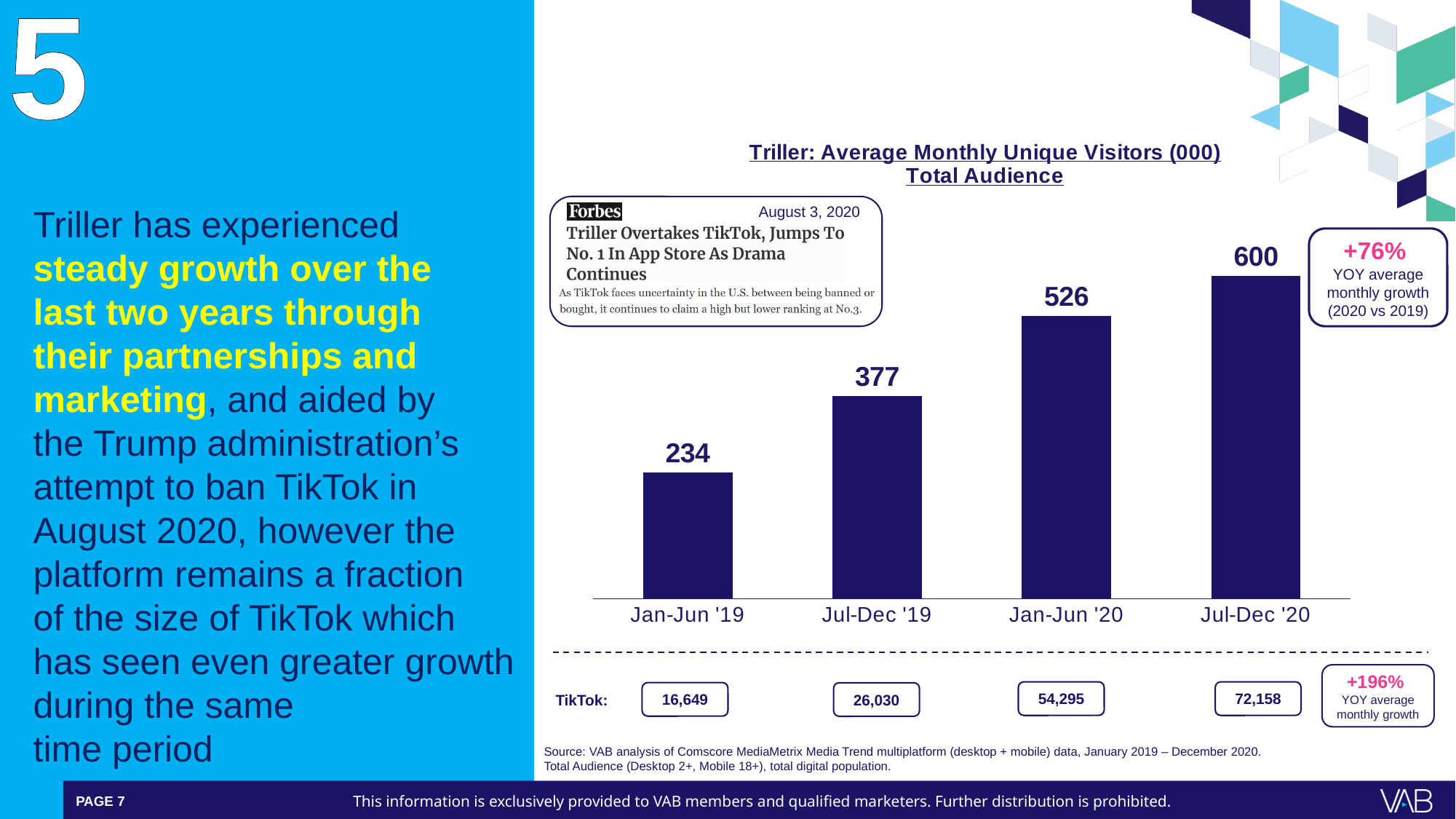
What YOY average monthly growth (2020 vs 2019) is shown in the callout next to the Triller chart? +76% In the Triller: Average Monthly Unique Visitors chart, which is larger: Jul-Dec '19 or Jan-Jun '20? Jan-Jun '20 What kind of chart is the Triller: Average Monthly Unique Visitors chart? Bar chart What is the value for Jan-Jun '19 in the Triller: Average Monthly Unique Visitors chart? 234 What is the value for Jan-Jun '20 in the Triller: Average Monthly Unique Visitors chart? 526 How many periods are shown in the Triller: Average Monthly Unique Visitors chart? 4 What is the difference between the Jul-Dec '20 and Jan-Jun '19 values in the Triller: Average Monthly Unique Visitors chart? 366 What is the value for Jul-Dec '20 in the Triller: Average Monthly Unique Visitors chart? 600 Which period has the lowest value in the Triller: Average Monthly Unique Visitors chart? Jan-Jun '19 What is the difference between the Jan-Jun '20 and Jul-Dec '19 values in the Triller: Average Monthly Unique Visitors chart? 149 Which period has the highest value in the Triller: Average Monthly Unique Visitors chart? Jul-Dec '20 Do the values in the Triller: Average Monthly Unique Visitors chart rise or fall from Jan-Jun '19 to Jul-Dec '20? Rise